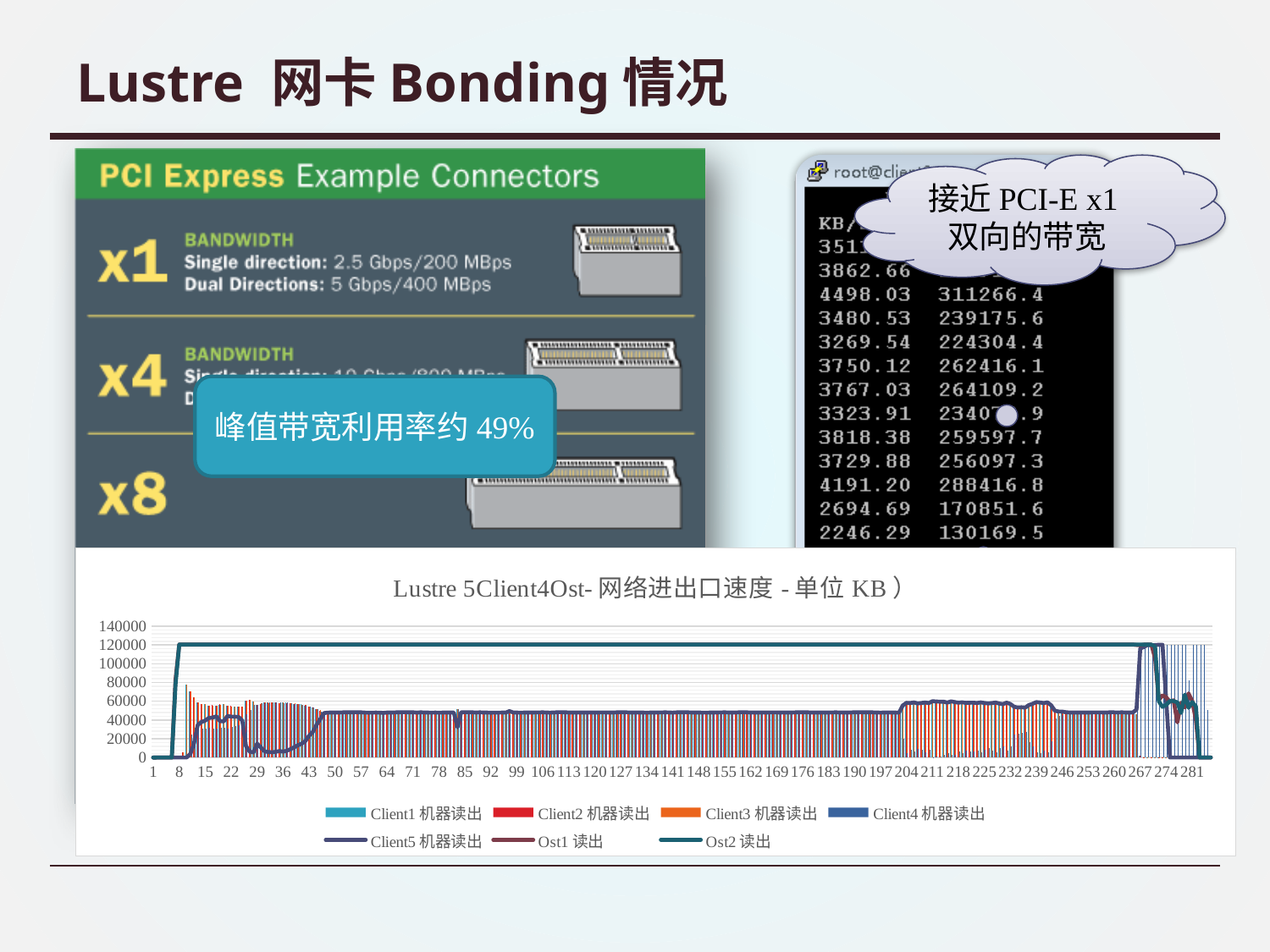
Around x = 120, which is larger: the Ost2 读出 line or the Client1 机器读出 bars? Ost2 读出 What is the last x-axis label shown on the chart? 281 What kind of chart is shown on the slide? Combined bar and line chart Is the value of the Ost2 读出 line at x = 99 greater or less than 100000? greater Is the value of the Ost2 读出 line at x = 1 greater or less than 20000? less What is the highest value shown on the chart's vertical axis? 140000 Is the value of the Ost2 读出 line at x = 50 greater or less than 80000? greater How many series does the chart's legend list? 7 What is the title of the chart on the slide? Lustre 5Client4Ost- 网络进出口速度 - 单位 KB）